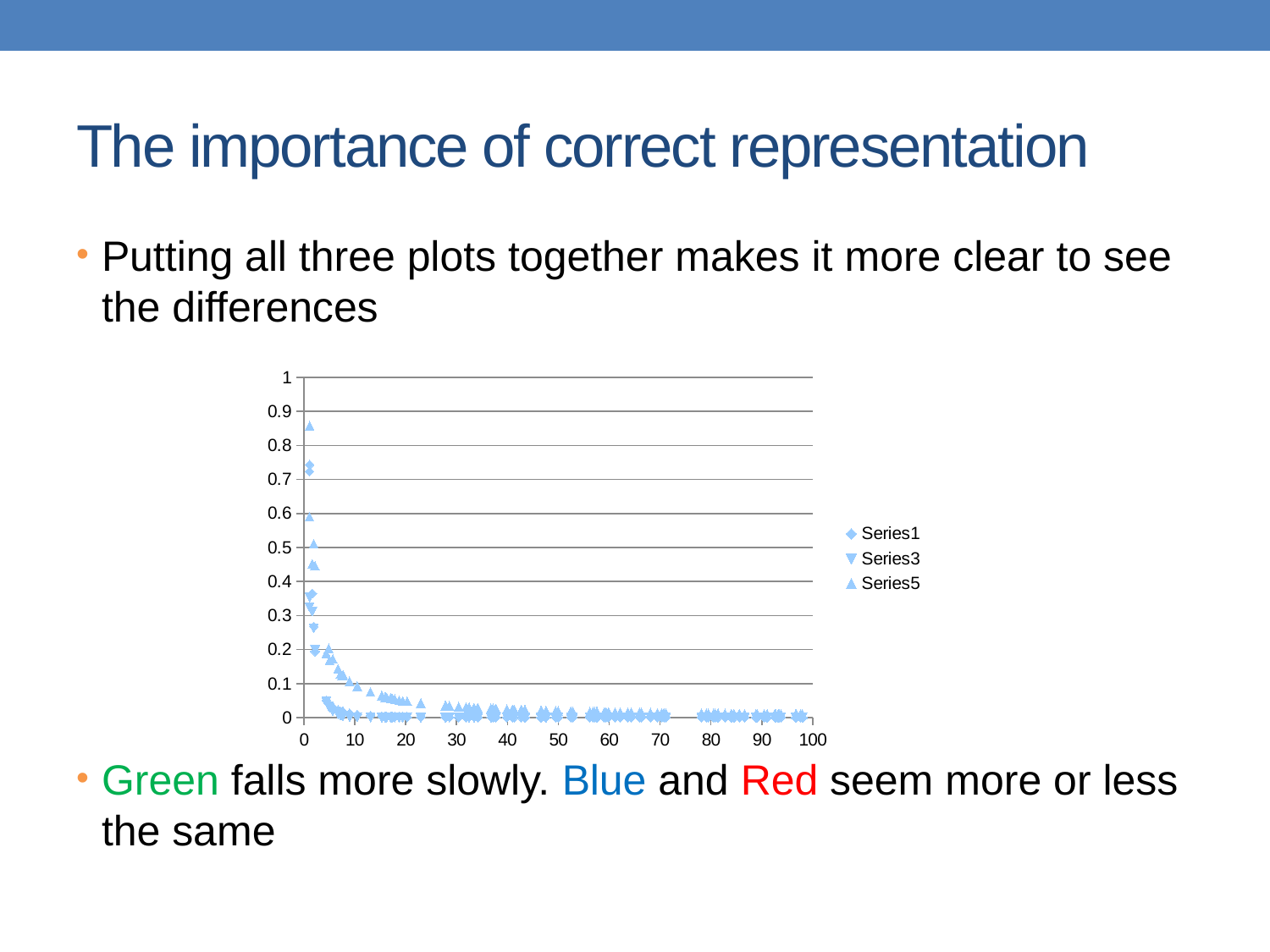
Are the values for Series5 at x = 90 greater or less than 0.1? less Is the highest value for Series3 greater or less than 0.5? less Is the highest value for Series1 greater or less than 0.5? greater Which series reaches the highest value on the chart? Series5 What kind of chart is shown on the slide? Scatter chart How many series does the chart's legend list? 3 Do the plotted values rise or fall as the x axis increases? fall What is the highest tick value shown on the chart's y axis? 1 Which series has the larger maximum value, Series5 or Series3? Series5 What are the names of the series listed in the chart's legend? Series1, Series3, Series5